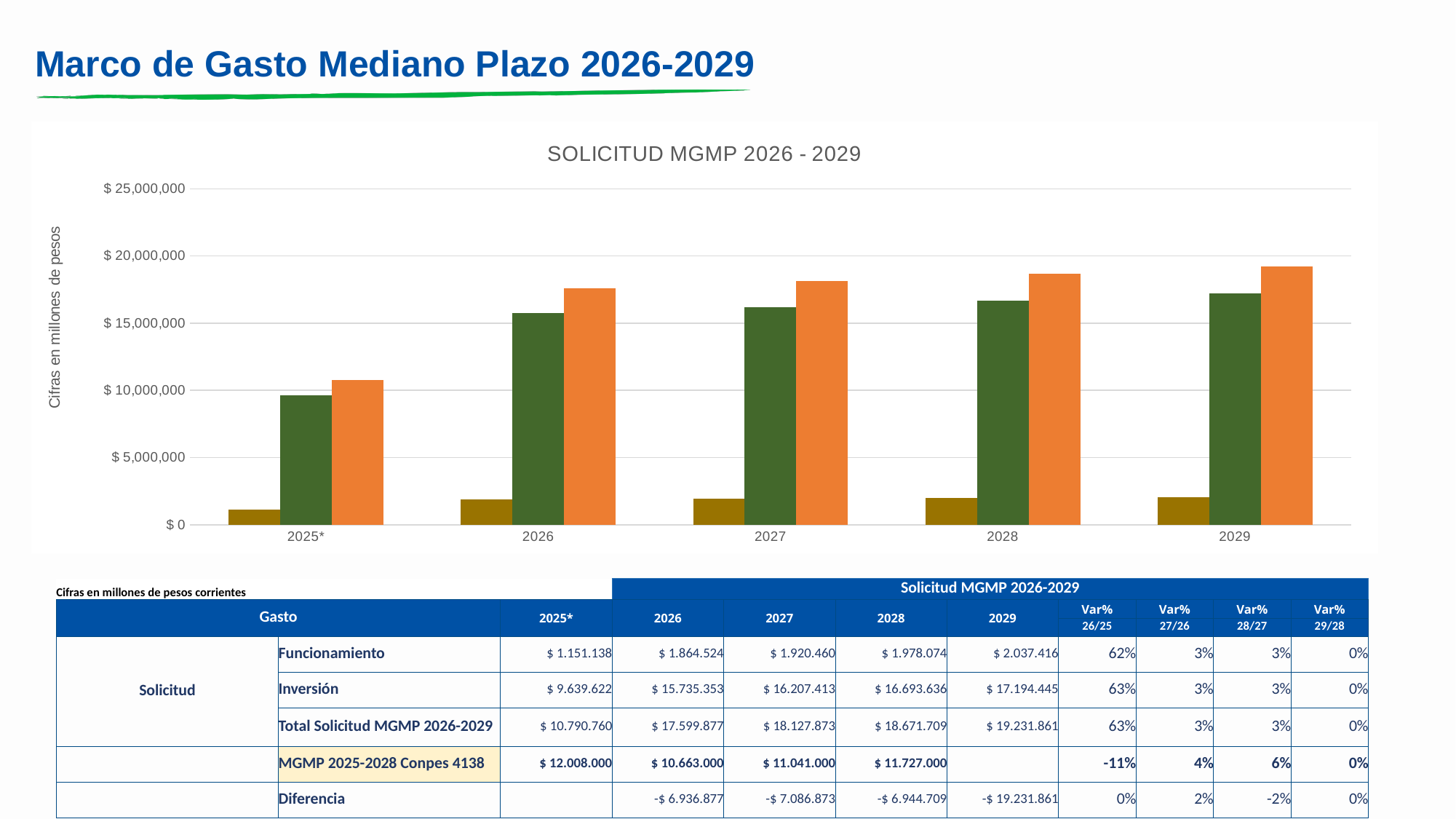
In which year is the orange bar the tallest? 2029 What is the title of the chart? SOLICITUD MGMP 2026 - 2029 Do the orange bars rise or fall from 2025* to 2029? rise Is the orange bar for 2025* greater or less than $ 10,000,000? greater Is the green bar for 2025* greater or less than $ 10,000,000? less In which year is the green bar the shortest? 2025* How many year categories are shown on the x axis of the chart? 5 What kind of chart is shown on the slide? bar chart How many bars are shown for each year category in the chart? 3 Is the green bar for 2026 greater or less than $ 15,000,000? greater What is the label on the vertical axis of the chart? Cifras en millones de pesos